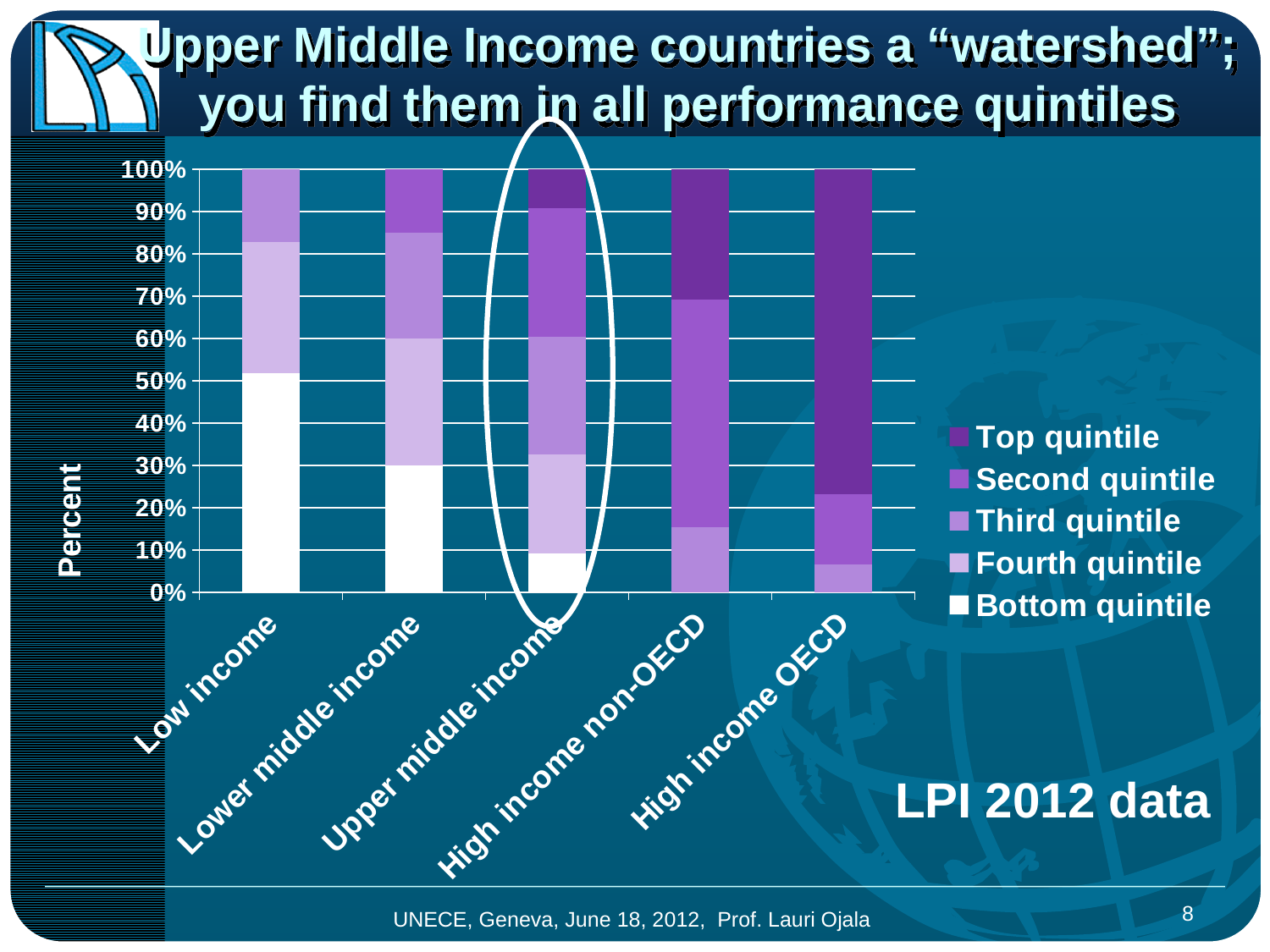
How many series does the chart's legend list? 5 Is the Bottom quintile share for Low income greater or less than 40%? greater Which income category has the largest Bottom quintile share? Low income Is the Bottom quintile share for Upper middle income greater or less than 20%? less What is the title of the chart's vertical axis? Percent Which income category is circled on the chart? Upper middle income How many income categories are shown on the x axis of the chart? 5 Which has a larger Top quintile share: High income OECD or High income non-OECD? High income OECD What kind of chart is shown on the slide? Stacked bar chart Which has a larger Bottom quintile share: Low income or Lower middle income? Low income Is the Top quintile share for High income OECD greater or less than 70%? greater Which income category has the largest Top quintile share? High income OECD